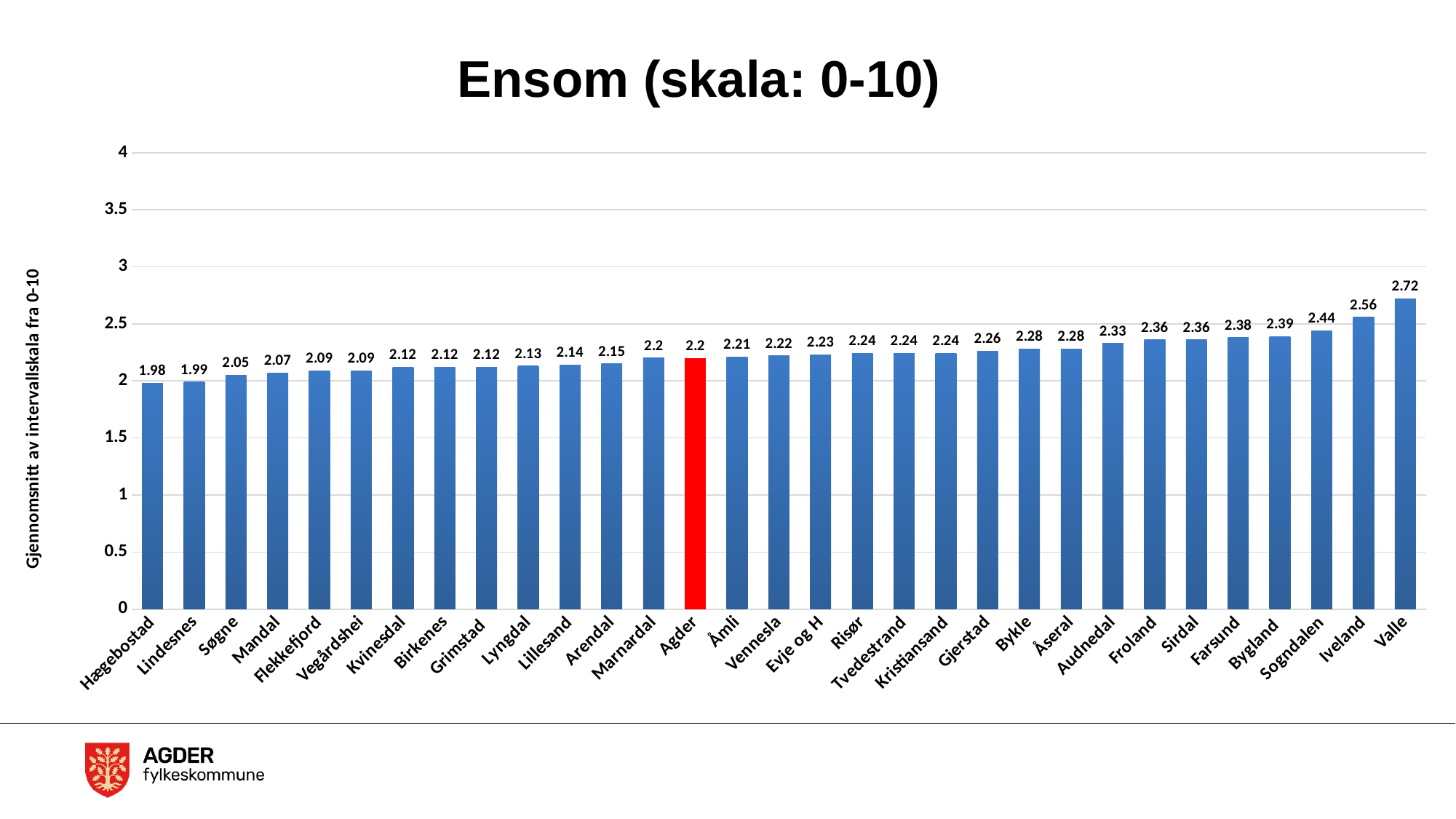
How many categories are shown on the x axis? 31 Which category has the lowest value? Hægebostad Which is larger, the value for Iveland or the value for Sogndalen? Iveland What is the value for Valle? 2.72 Which bar is coloured red? Agder What is the difference between the values for Valle and Hægebostad? 0.74 What is the value for Agder? 2.2 What kind of chart is this? bar chart What is the value for Kristiansand? 2.24 Which category has the highest value? Valle Do the values rise or fall from left to right along the x axis? rise Is the value for Lindesnes greater or less than 2? less